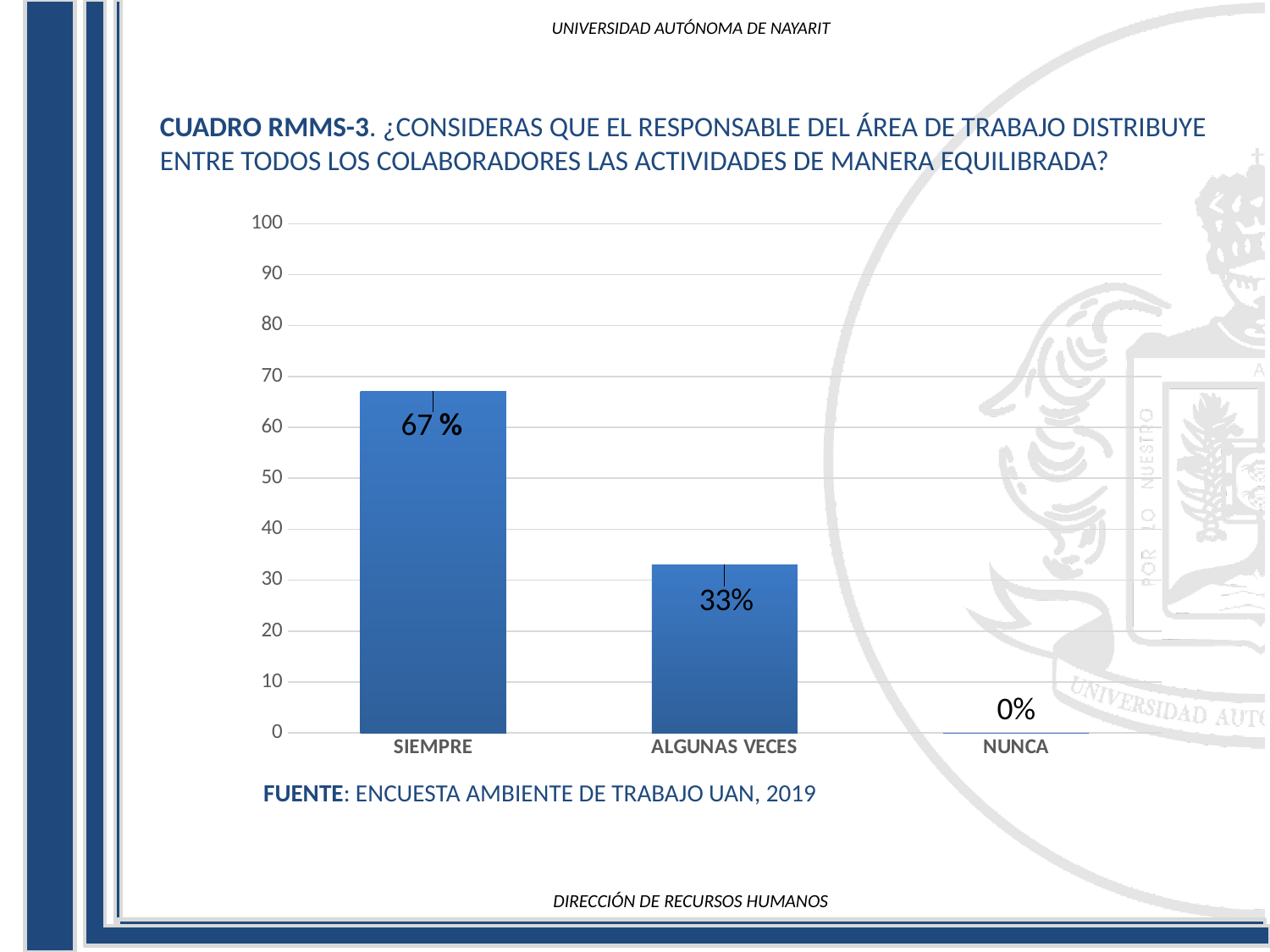
What is the difference between the values for SIEMPRE and ALGUNAS VECES? 34% Is the value for SIEMPRE greater or less than 50? greater What kind of chart is shown on the slide? bar chart Which category has the lowest value? NUNCA What is the value for ALGUNAS VECES? 33% Do the values rise or fall from left to right along the x axis? fall Which is larger, the value for ALGUNAS VECES or the value for NUNCA? ALGUNAS VECES How many categories are shown on the x axis? 3 What is the value for NUNCA? 0% What is the value for SIEMPRE? 67% Is the value for ALGUNAS VECES greater or less than 40? less Which category has the highest value? SIEMPRE